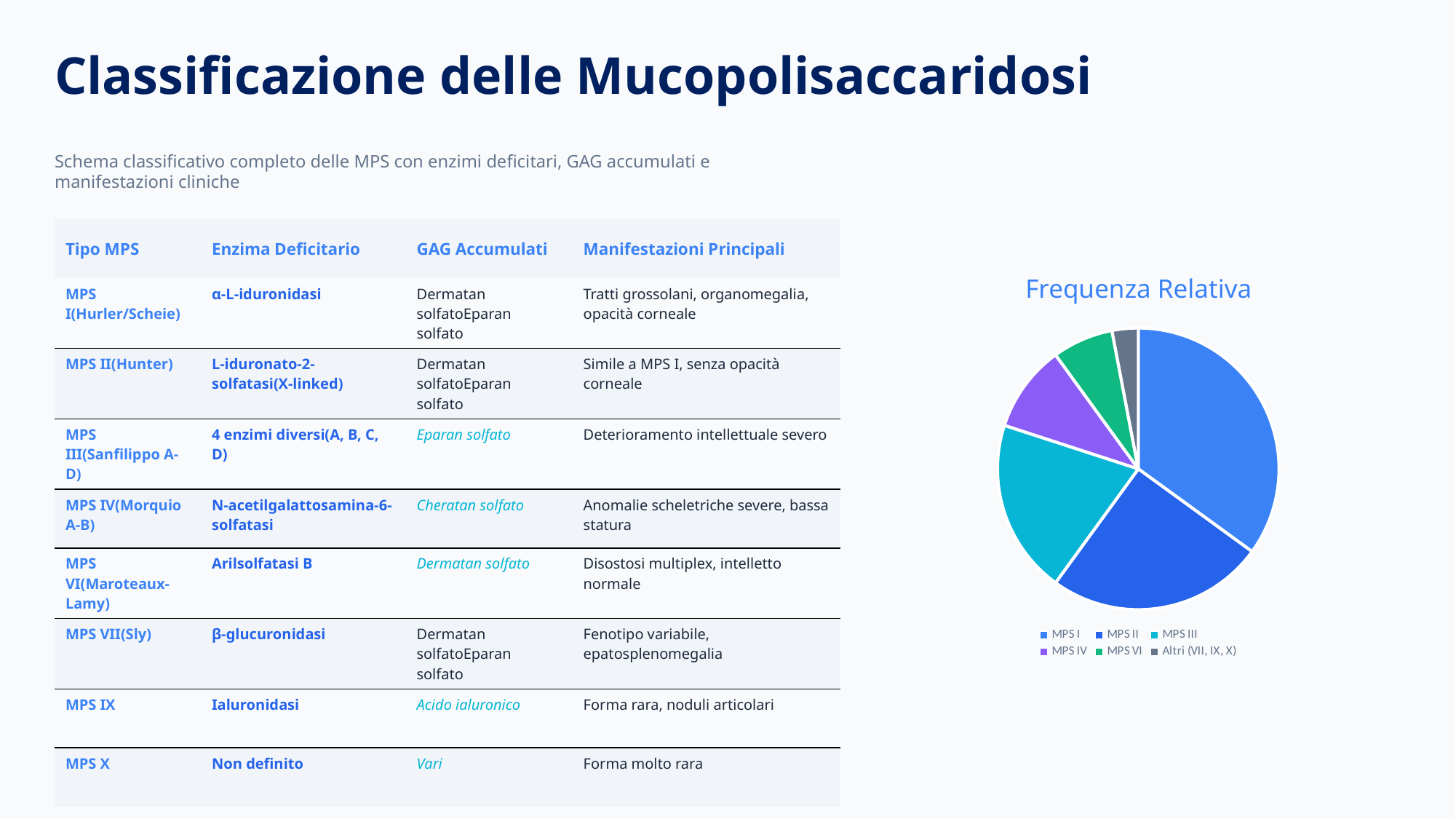
How many slices does the pie chart have? 6 Which slice is larger in the pie chart, MPS I or MPS III? MPS I Which legend entry in the pie chart is shown in green? MPS VI Which slice is larger in the pie chart, MPS III or MPS VI? MPS III What is the title of the chart on the slide? Frequenza Relativa Which slice is larger in the pie chart, MPS II or MPS IV? MPS II What kind of chart is shown on the slide? pie chart Which category has the largest slice in the pie chart? MPS I Which category has the smallest slice in the pie chart? Altri (VII, IX, X)